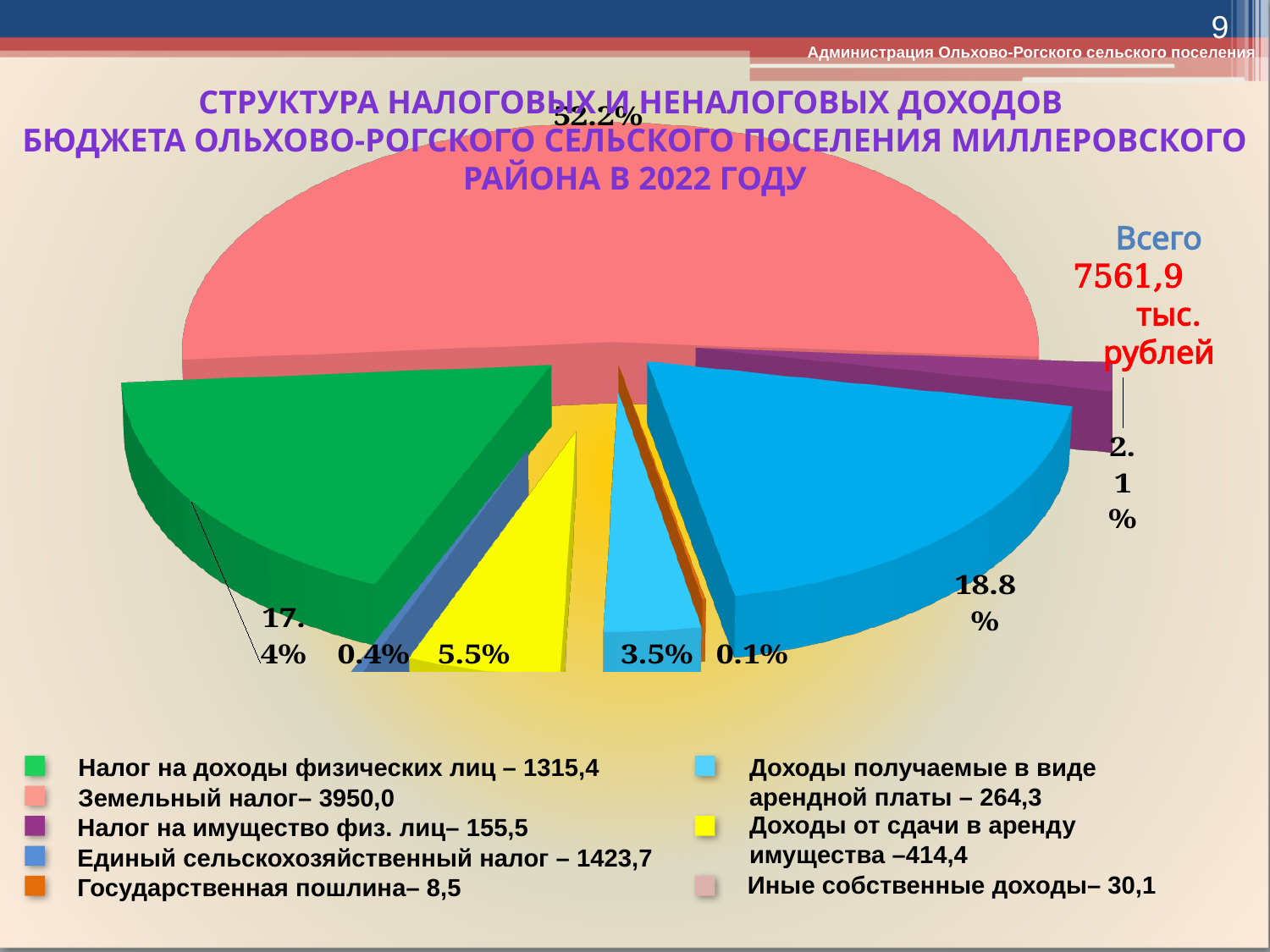
What is the value shown in the legend for Земельный налог? 3950,0 What is the value shown in the legend for Единый сельскохозяйственный налог? 1423,7 Which category has the largest slice of the pie? Земельный налог Which category has the smallest value in the legend? Государственная пошлина What kind of chart is shown on the slide? pie chart What is the value shown in the legend for Государственная пошлина? 8,5 What total amount (Всего) is stated on the slide? 7561,9 тыс. рублей How many categories does the legend list? 8 What is the value shown in the legend for Иные собственные доходы? 30,1 Which is larger: Единый сельскохозяйственный налог or Налог на доходы физических лиц? Единый сельскохозяйственный налог What share of the pie does the largest slice (Земельный налог) represent? 52.2% What is the value shown in the legend for Налог на доходы физических лиц? 1315,4